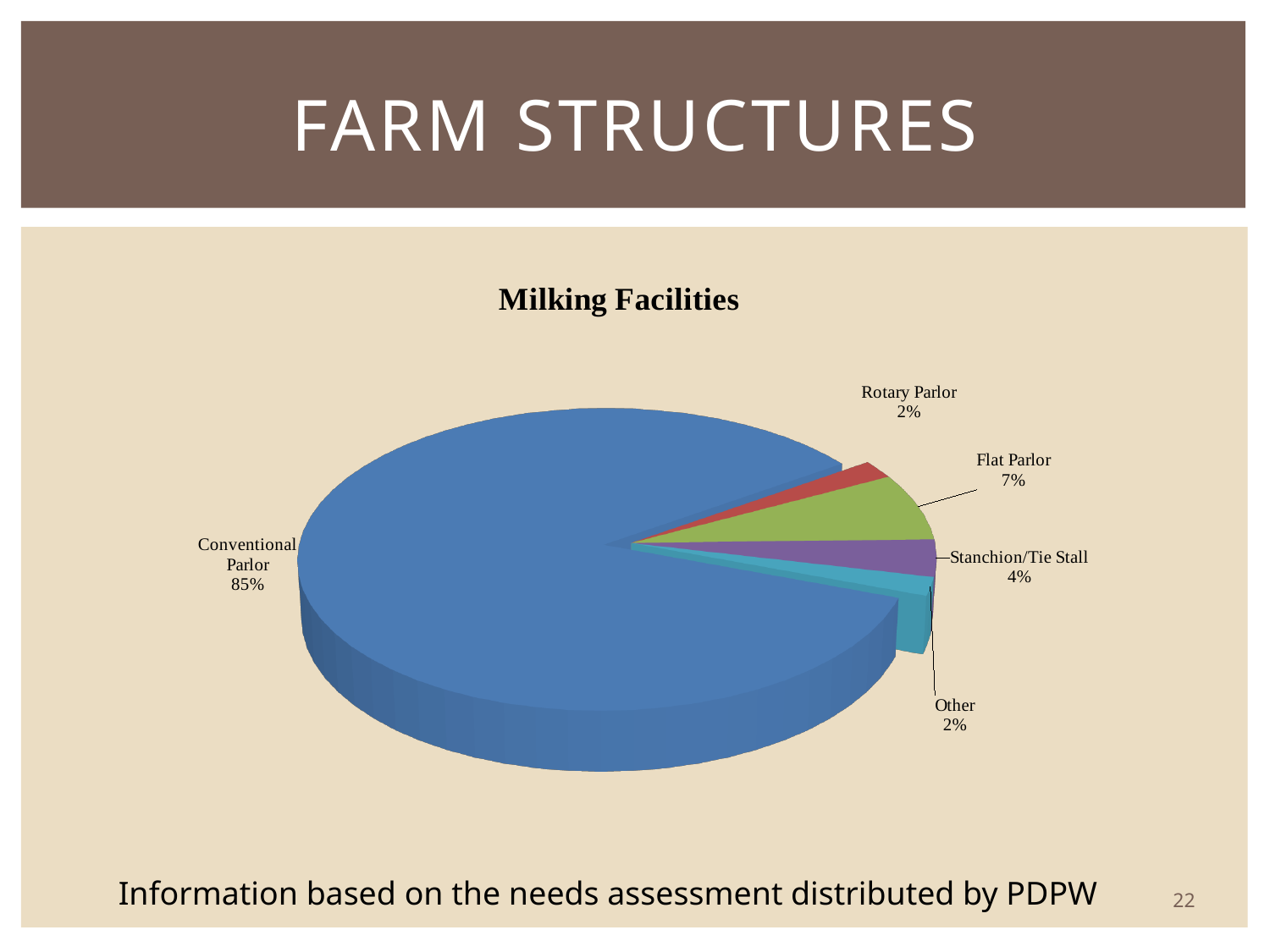
How many slices does the Milking Facilities pie chart have? 5 What kind of chart is shown on the slide? Pie chart What is the difference in percentage points between Flat Parlor and Stanchion/Tie Stall? 3 What share of the Milking Facilities pie is Conventional Parlor? 85% What is the title of the chart? Milking Facilities What is the difference in percentage points between Conventional Parlor and Flat Parlor? 78 What percentage is shown for Flat Parlor? 7% Which milking facility type has the largest share of the pie? Conventional Parlor What percentage is shown for Other? 2% Which is larger, the share for Flat Parlor or the share for Stanchion/Tie Stall? Flat Parlor What percentage is shown for Stanchion/Tie Stall? 4% What percentage is shown for Rotary Parlor? 2%